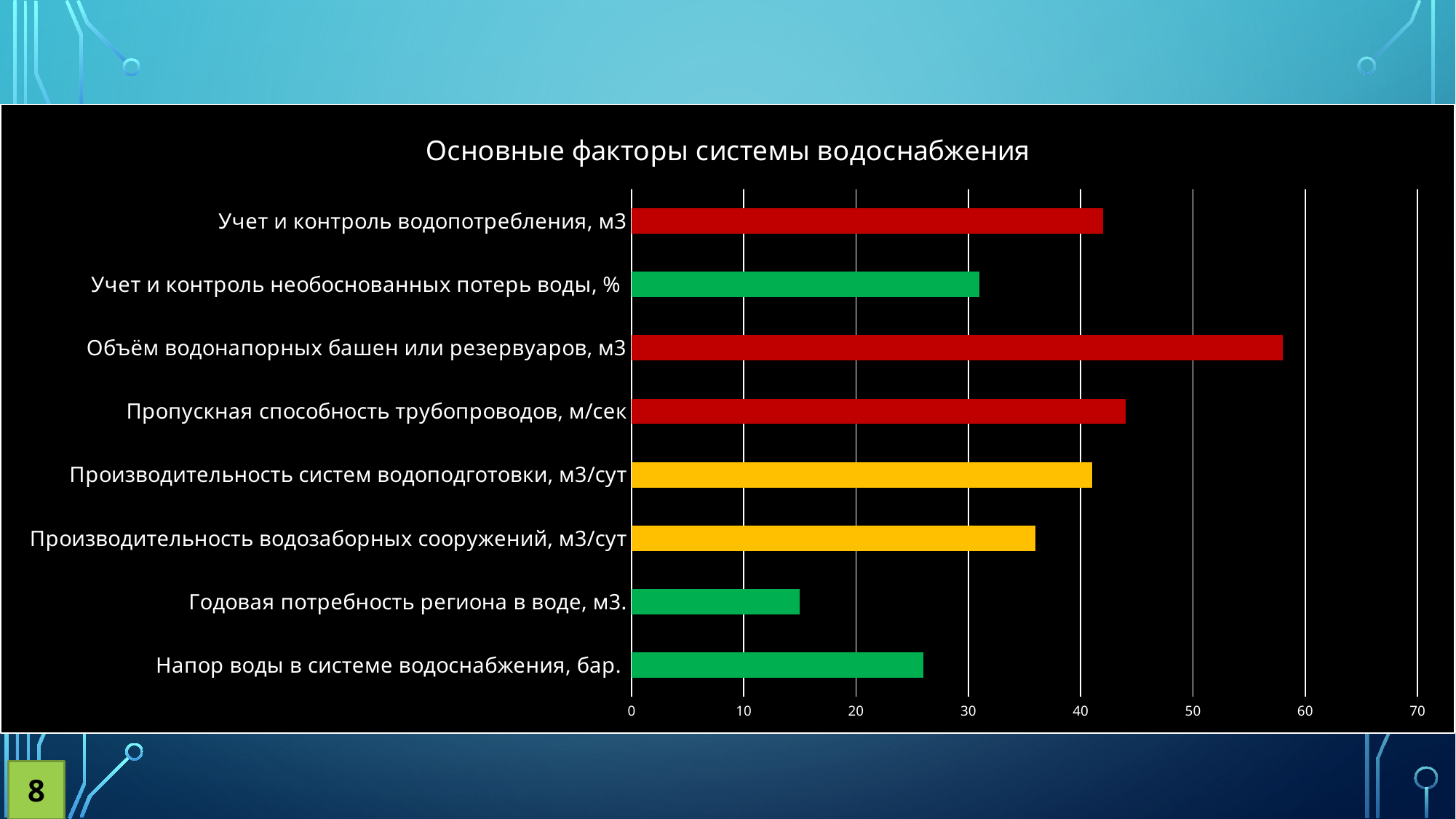
How many categories are plotted in the chart? 8 Is the value for Объём водонапорных башен или резервуаров, м3 greater or less than 60? less Is the value for Напор воды в системе водоснабжения, бар. greater or less than 30? less Is the value for Годовая потребность региона в воде, м3. greater or less than 10? greater Which category has the lowest value? Годовая потребность региона в воде, м3. Which is larger: the value for Учет и контроль водопотребления, м3 or the value for Учет и контроль необоснованных потерь воды, %? Учет и контроль водопотребления, м3 Which category has the highest value? Объём водонапорных башен или резервуаров, м3 Which is larger: the value for Напор воды в системе водоснабжения, бар. or the value for Годовая потребность региона в воде, м3.? Напор воды в системе водоснабжения, бар. What kind of chart is shown on the slide? bar chart What is the title of the chart? Основные факторы системы водоснабжения